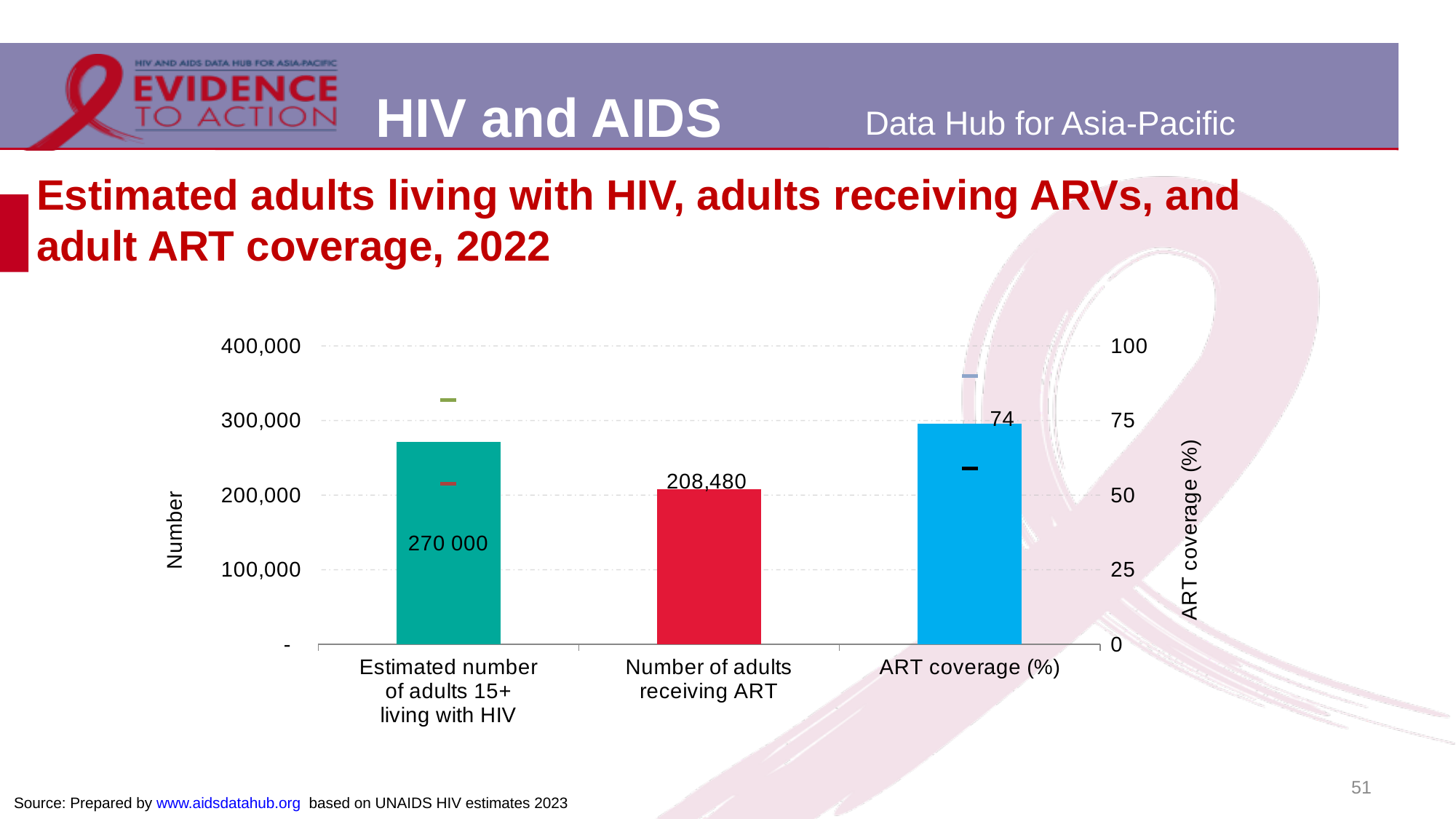
What is the estimated number of adults 15+ living with HIV shown on the chart? 270 000 How many categories are shown on the x axis of the chart? 3 What is the ART coverage (%) value shown on the chart? 74 What kind of chart is shown on the slide? Bar chart What year does the chart title refer to? 2022 What is the label of the left vertical axis of the chart? Number Which is larger: the estimated number of adults 15+ living with HIV or the number of adults receiving ART? Estimated number of adults 15+ living with HIV What is the number of adults receiving ART shown on the chart? 208,480 Is the number of adults receiving ART greater or less than 300,000? less Is the ART coverage (%) greater or less than 50 on the right-hand axis? greater What is the difference between the estimated number of adults 15+ living with HIV and the number of adults receiving ART? 61,520